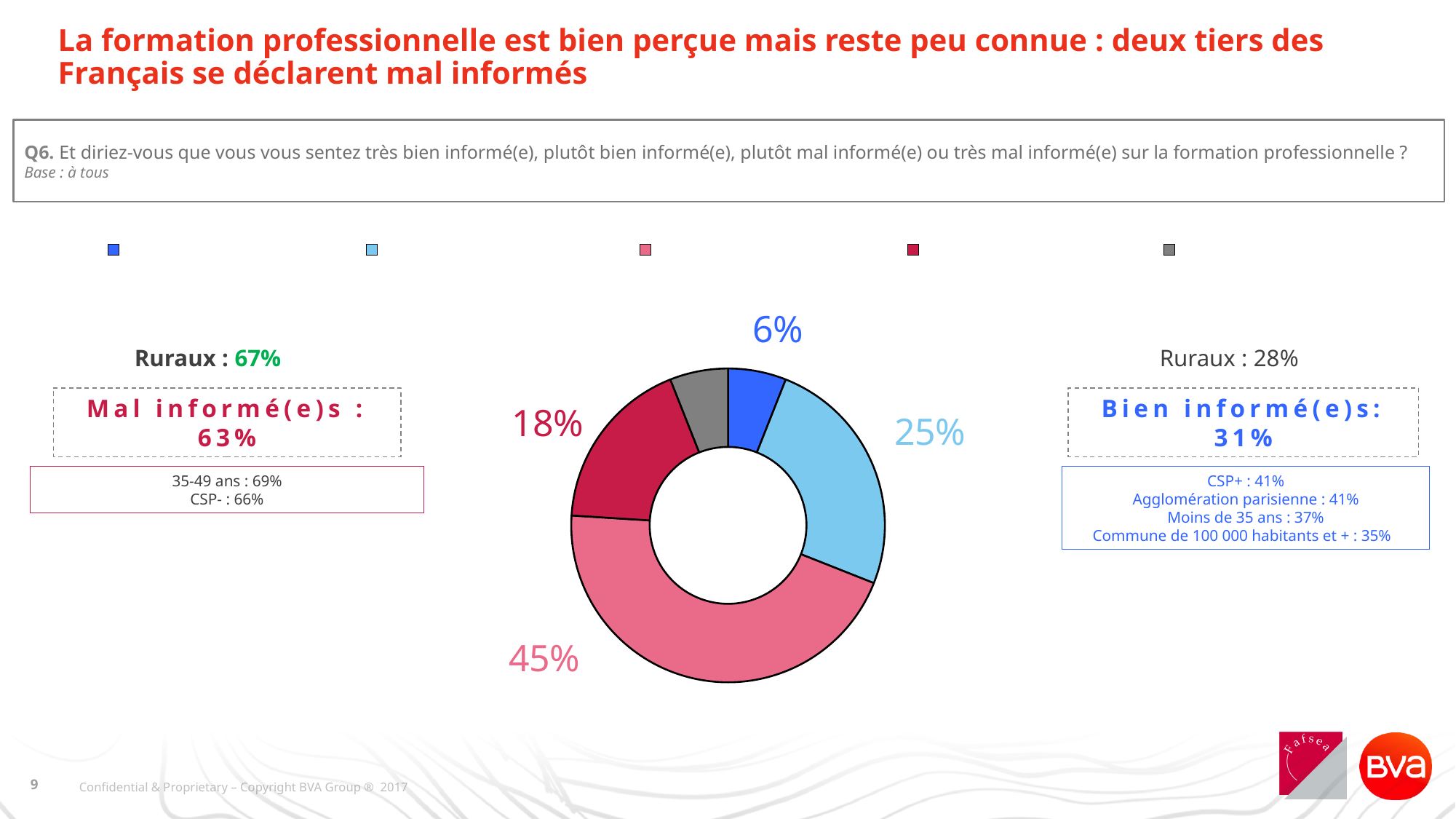
What is the value of the dark blue slice of the donut chart? 6% What is the difference between the pink slice (45%) and the light blue slice (25%)? 20 percentage points What kind of chart is shown on the slide? pie chart (donut) According to the text box on the left, what share of respondents are 'Mal informé(e)s'? 63% What is the value of the pink slice of the donut chart? 45% How many slices does the donut chart have? 5 What is the value of the light blue slice of the donut chart? 25% Which slice of the donut chart is the largest? the pink slice (45%) What is the value of the dark red slice of the donut chart? 18% What is the difference between the light blue slice (25%) and the dark red slice (18%)? 7 percentage points How many entries does the legend above the chart list? 5 Which is larger, the light blue slice or the dark red slice? the light blue slice